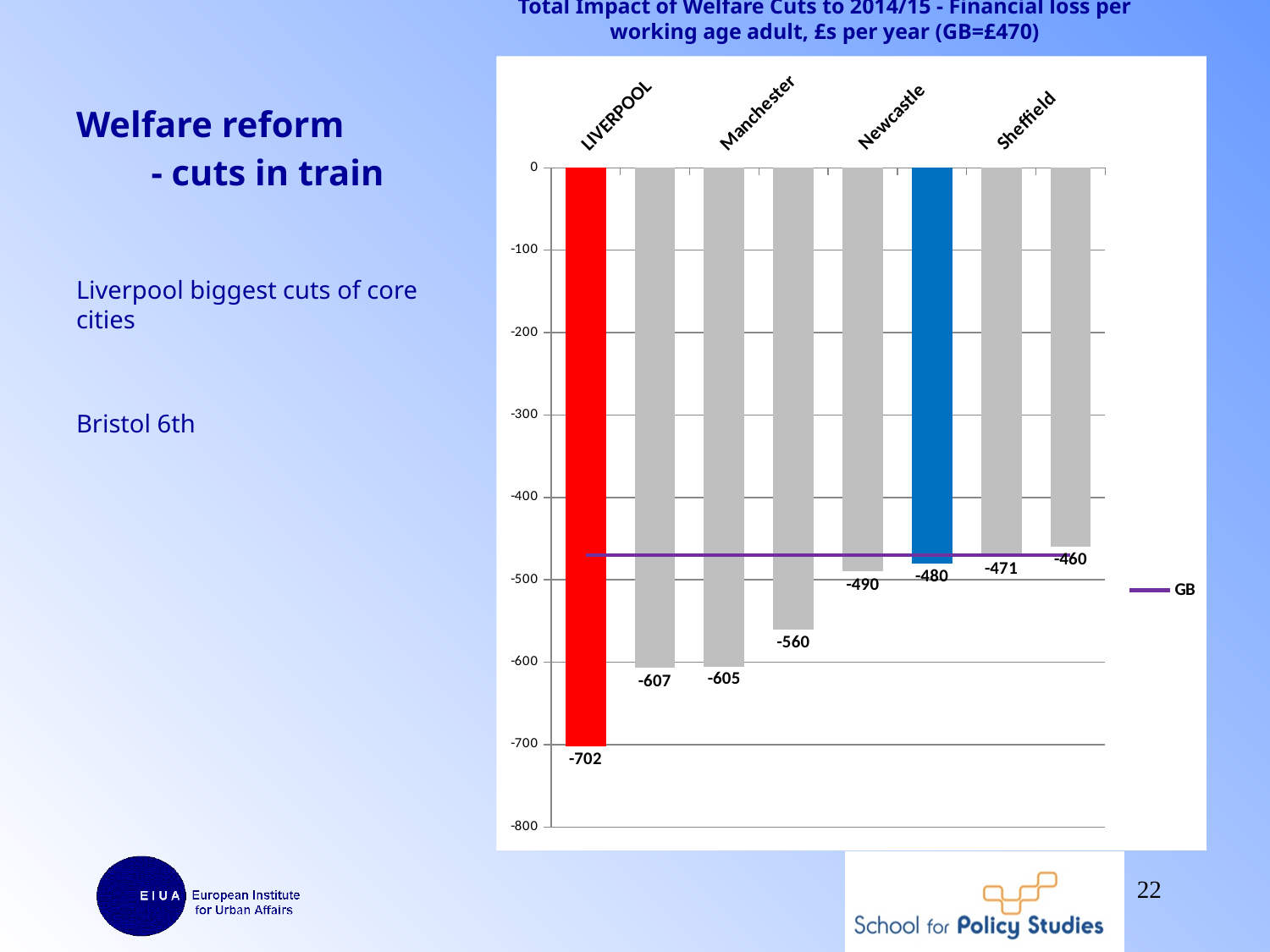
How many bars are plotted in the chart? 8 What is the difference between the two bars labelled -607 and -605? 2 What is the financial loss per working age adult shown for Liverpool? -702 What is the GB value given in the chart title? £470 Is the value for Liverpool greater or less than -700? less Which city has the largest financial loss (the lowest bar) in the chart? Liverpool What is the smallest financial loss value labelled on any bar in the chart? -460 What is the difference between the Liverpool bar (-702) and the smallest bar (-460)? 242 How many entries does the chart legend list? 1 What colour is the Liverpool bar? Red How many bars have a value below -600? 3 What kind of chart is shown on the slide? Bar chart